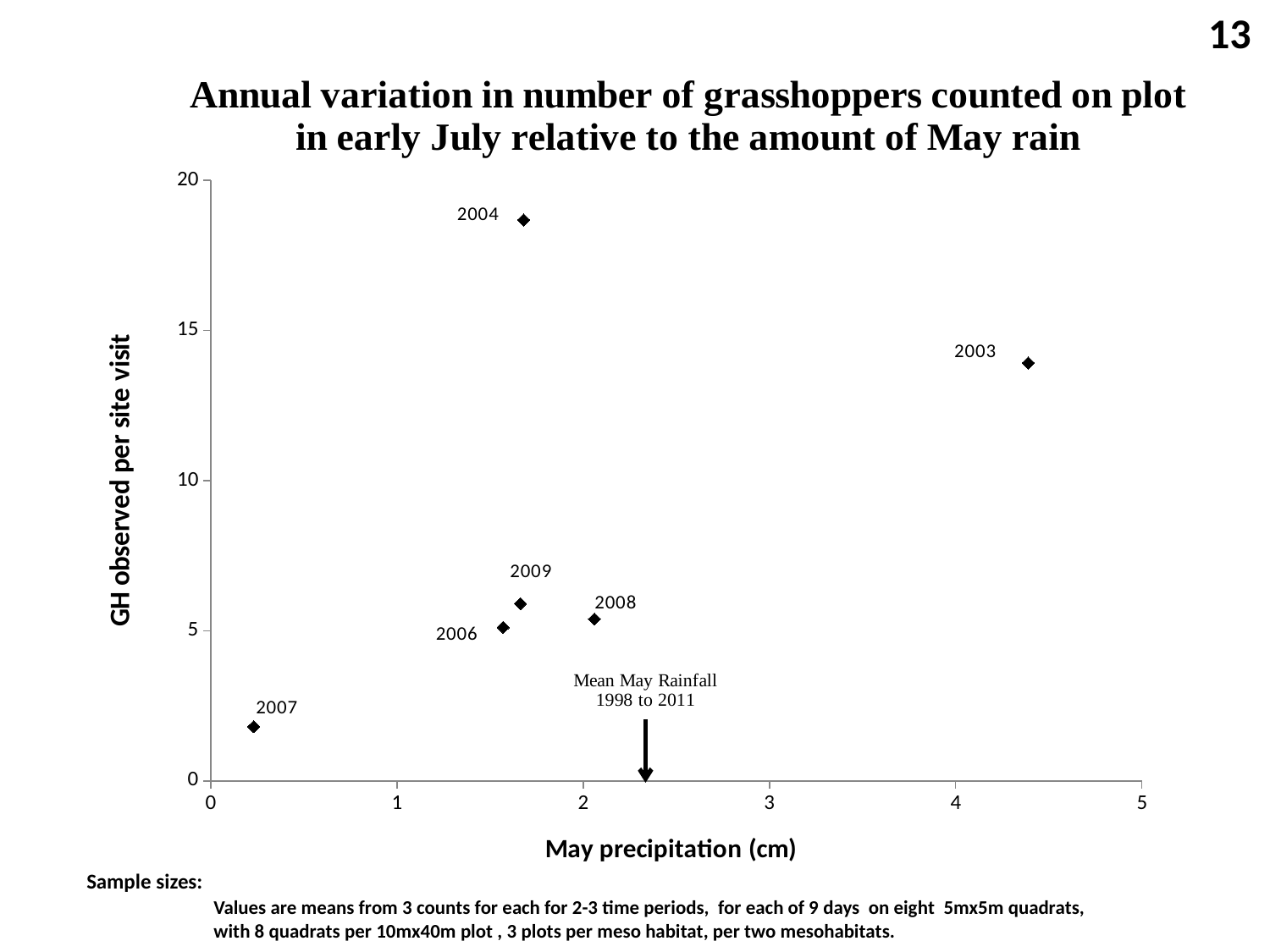
Which year has the lowest number of GH observed per site visit? 2007 What kind of chart is shown on the slide? Scatter plot Which year had more GH observed per site visit, 2006 or 2007? 2006 Is the GH observed per site visit for 2003 greater or less than 15? less Which year has the highest number of GH observed per site visit? 2004 How many data points (years) are plotted on the chart? 6 Which year had the lowest May precipitation? 2007 Is the GH observed per site visit for 2004 greater or less than 15? greater Which year had the highest May precipitation? 2003 Is the May precipitation for 2003 greater or less than 4 cm? greater Which year had higher May precipitation, 2003 or 2004? 2003 What is the label of the x axis? May precipitation (cm)